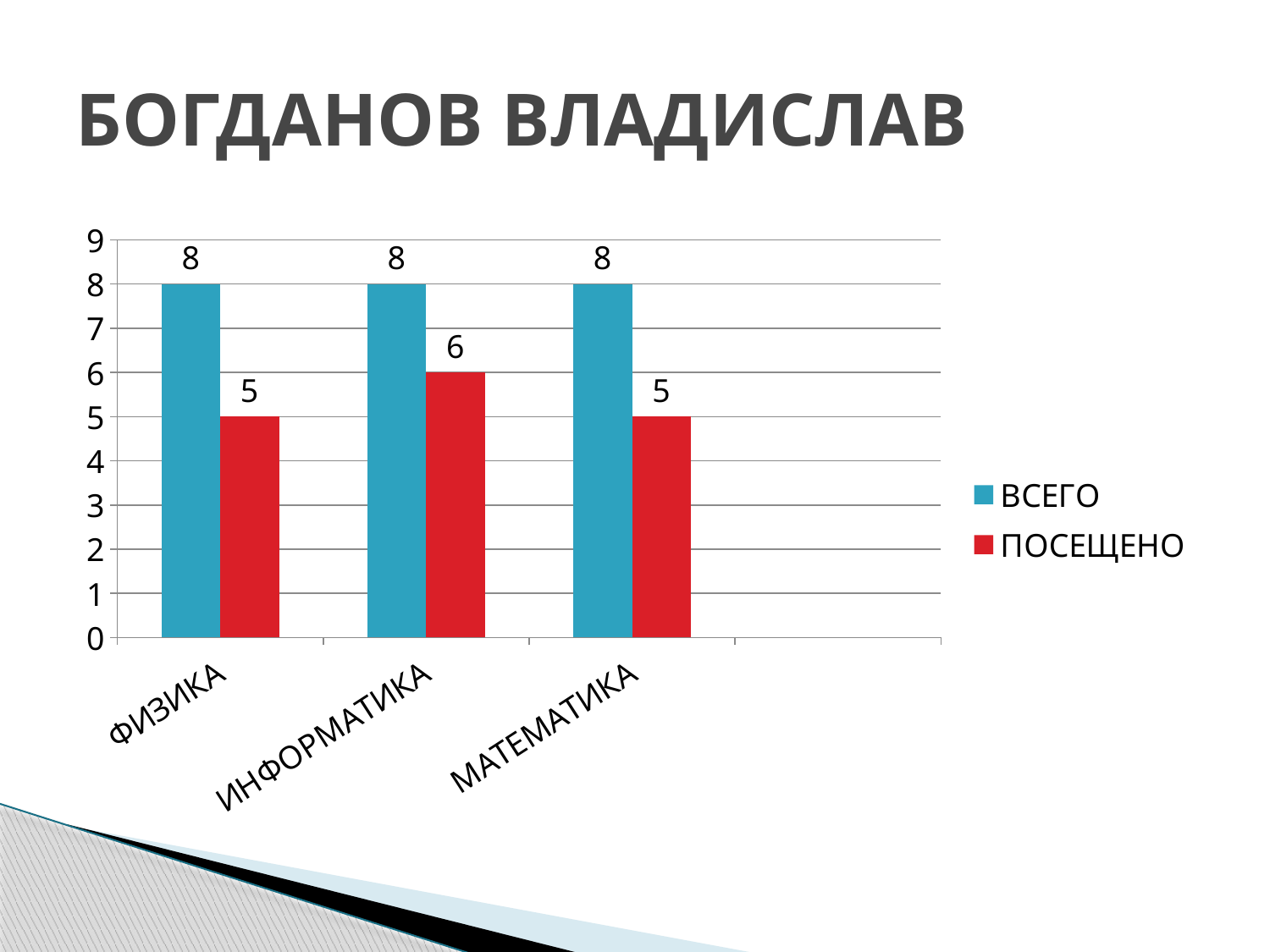
What is the ПОСЕЩЕНО value for ИНФОРМАТИКА? 6 Which category has the highest ПОСЕЩЕНО value? ИНФОРМАТИКА Which is larger for МАТЕМАТИКА, ВСЕГО or ПОСЕЩЕНО? ВСЕГО What is the ВСЕГО value for ФИЗИКА? 8 What is the difference between ВСЕГО and ПОСЕЩЕНО for ИНФОРМАТИКА? 2 What is the ПОСЕЩЕНО value for МАТЕМАТИКА? 5 How many series does the legend list? 2 What is the difference between ВСЕГО and ПОСЕЩЕНО for ФИЗИКА? 3 Is the ПОСЕЩЕНО value for ИНФОРМАТИКА greater or less than 5? greater What colour are the ПОСЕЩЕНО bars? red What kind of chart is shown on the slide? bar chart How many categories are shown on the x axis? 3